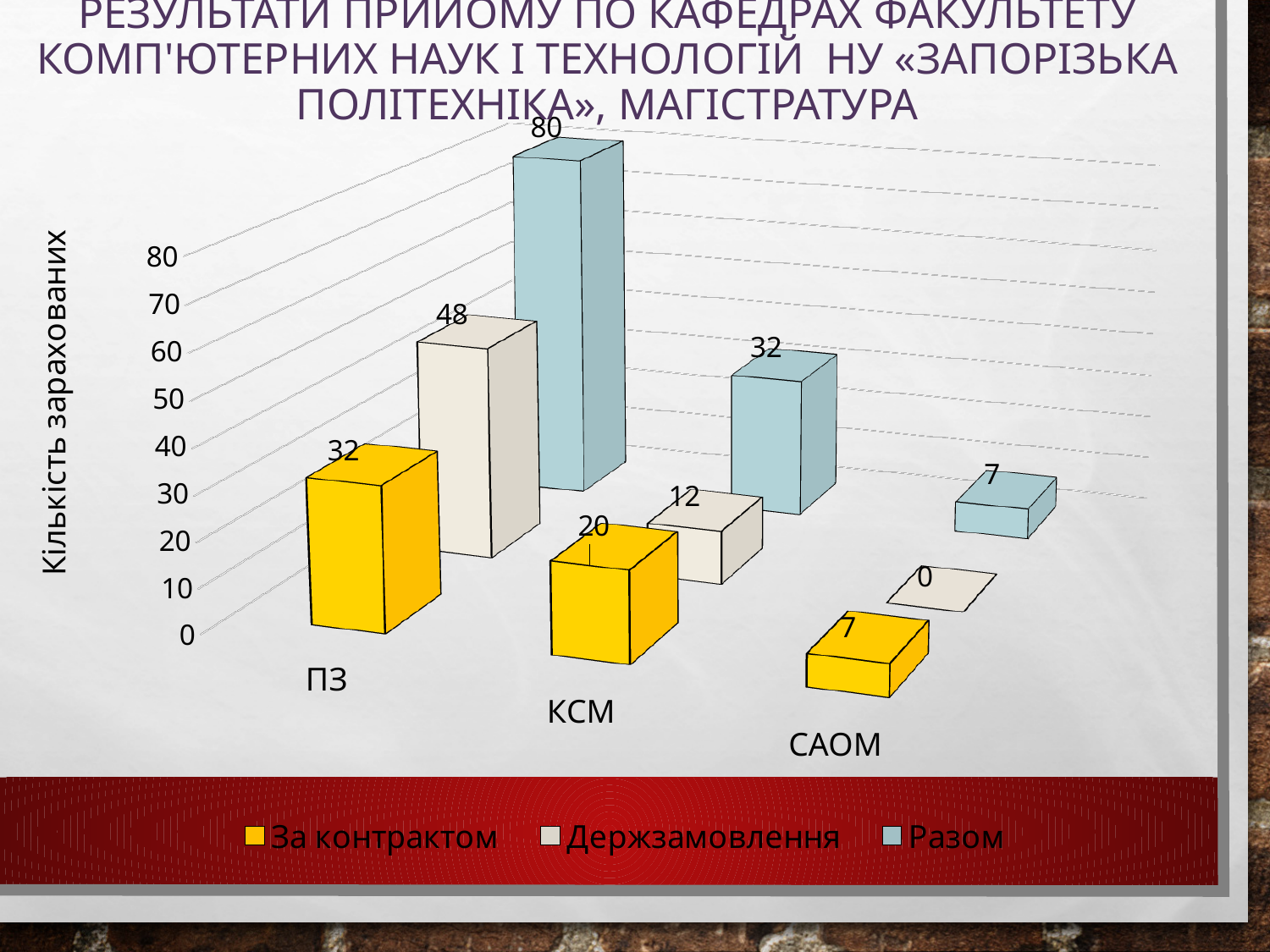
Which department has the highest Разом value? ПЗ What type of chart is shown on the slide? bar chart What is the value of Держзамовлення for КСМ? 12 How many series does the legend list? 3 What is the label of the vertical axis? Кількість зарахованих Which is larger for КСМ: За контрактом or Держзамовлення? За контрактом What is the difference between Держзамовлення for ПЗ and Держзамовлення for КСМ? 36 What is the value of Разом for ПЗ? 80 Which department has the lowest За контрактом value? САОМ What is the value of За контрактом for САОМ? 7 What is the value of Держзамовлення for САОМ? 0 How many categories (departments) are shown on the x axis? 3